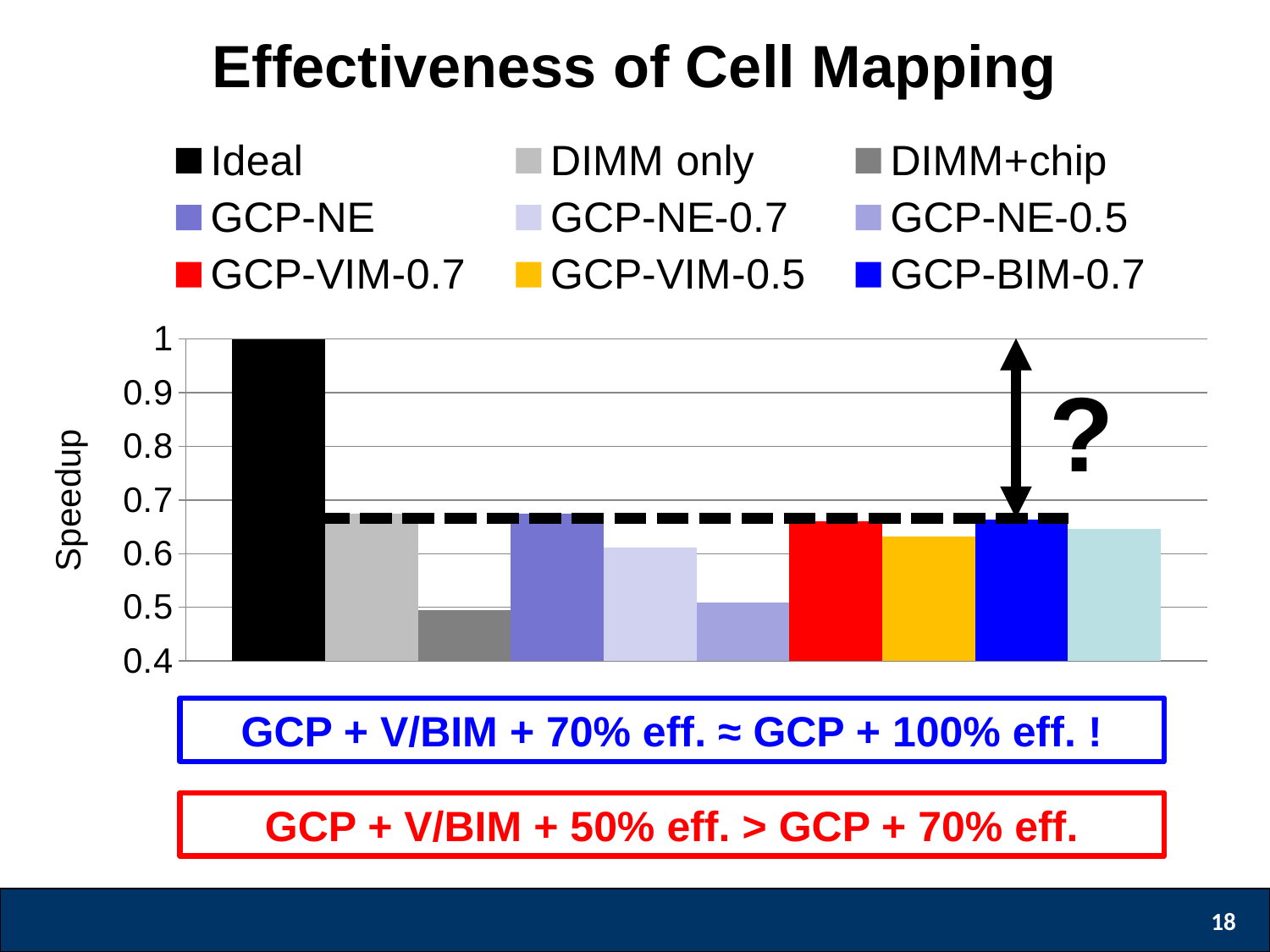
Is the value for DIMM+chip greater or less than 0.6? less Which series has the highest speedup? Ideal What kind of chart is shown on the slide? bar chart Which is larger, the value for DIMM only or the value for DIMM+chip? DIMM only What is the label on the y axis? Speedup Is the value for DIMM only greater or less than 0.7? less What is the speedup value for Ideal? 1 Which is larger, the value for GCP-NE or the value for GCP-NE-0.5? GCP-NE What colour is the Ideal bar? black Is the value for GCP-NE-0.5 greater or less than 0.6? less How many series does the legend list? 9